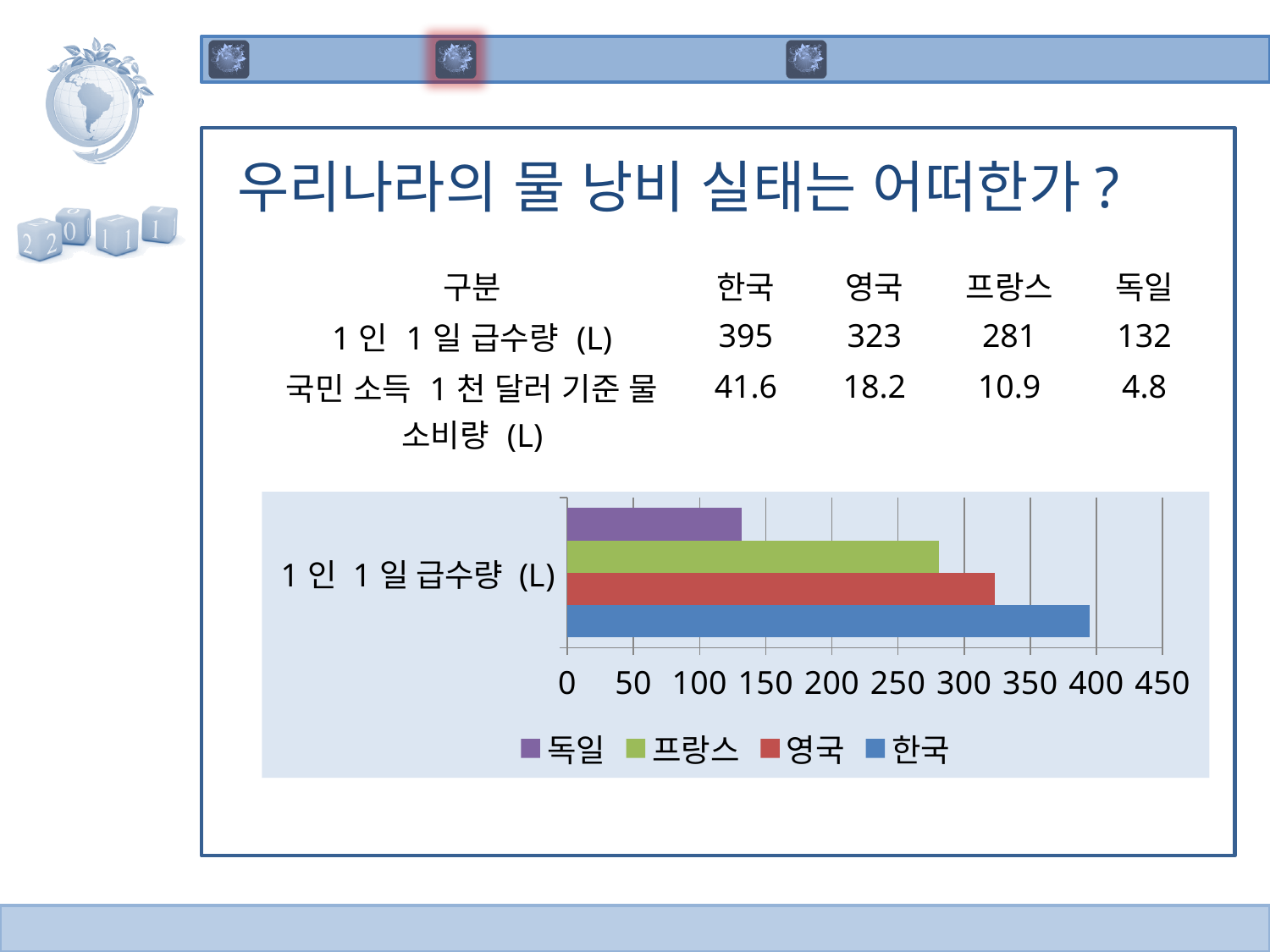
Which bar is longer, 영국 or 프랑스? 영국 What is the value of 1인 1일 급수량 (L) for 한국 as printed on the slide? 395 Is the bar for 프랑스 greater or less than 250? greater What colour is the bar for 한국 in the chart? blue What is the difference between the 1인 1일 급수량 (L) values for 한국 and 독일 printed on the slide? 263 Which country has the shortest bar in the chart? 독일 Is the bar for 독일 greater or less than 150? less Which country has the longest bar in the chart? 한국 Is the bar for 영국 greater or less than 350? less How many series does the chart legend list? 4 What kind of chart is shown on the slide? bar chart